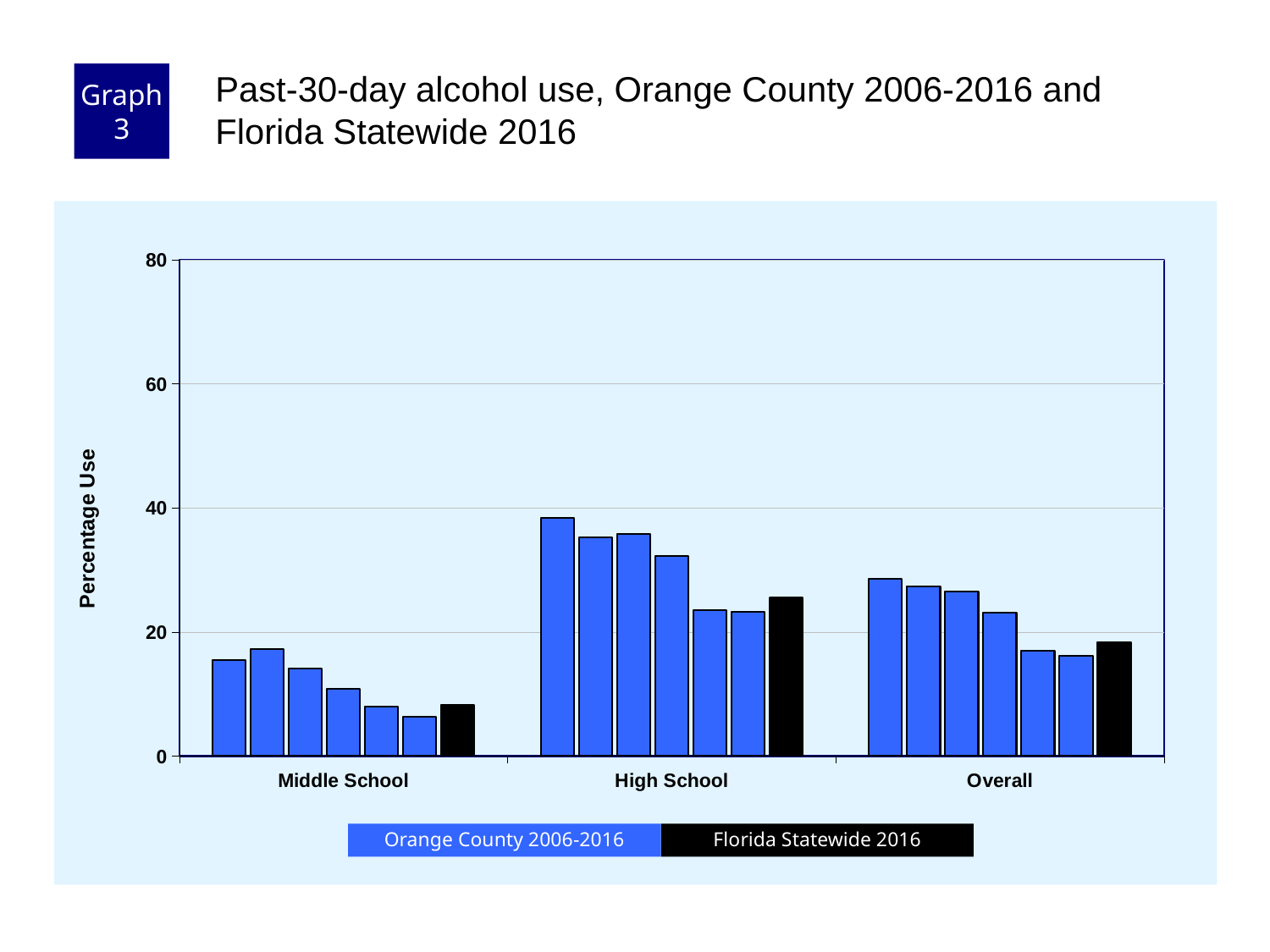
What kind of chart is shown on the slide? Bar chart Do the Orange County 2006-2016 bars for High School rise or fall from left to right? fall In the Middle School group, which is larger: the Florida Statewide 2016 bar or the rightmost Orange County 2006-2016 bar? Florida Statewide 2016 Is the Florida Statewide 2016 value for Overall greater or less than 10? greater Which category has the highest percentage use values? High School Which is larger, the Florida Statewide 2016 value for High School or for Overall? High School How many series does the legend list? 2 Which category has the lowest percentage use values? Middle School What is the title of the y axis? Percentage Use Is the Florida Statewide 2016 value for High School greater or less than 20? greater Is the Florida Statewide 2016 value for Middle School greater or less than 20? less How many categories are shown on the x axis? 3